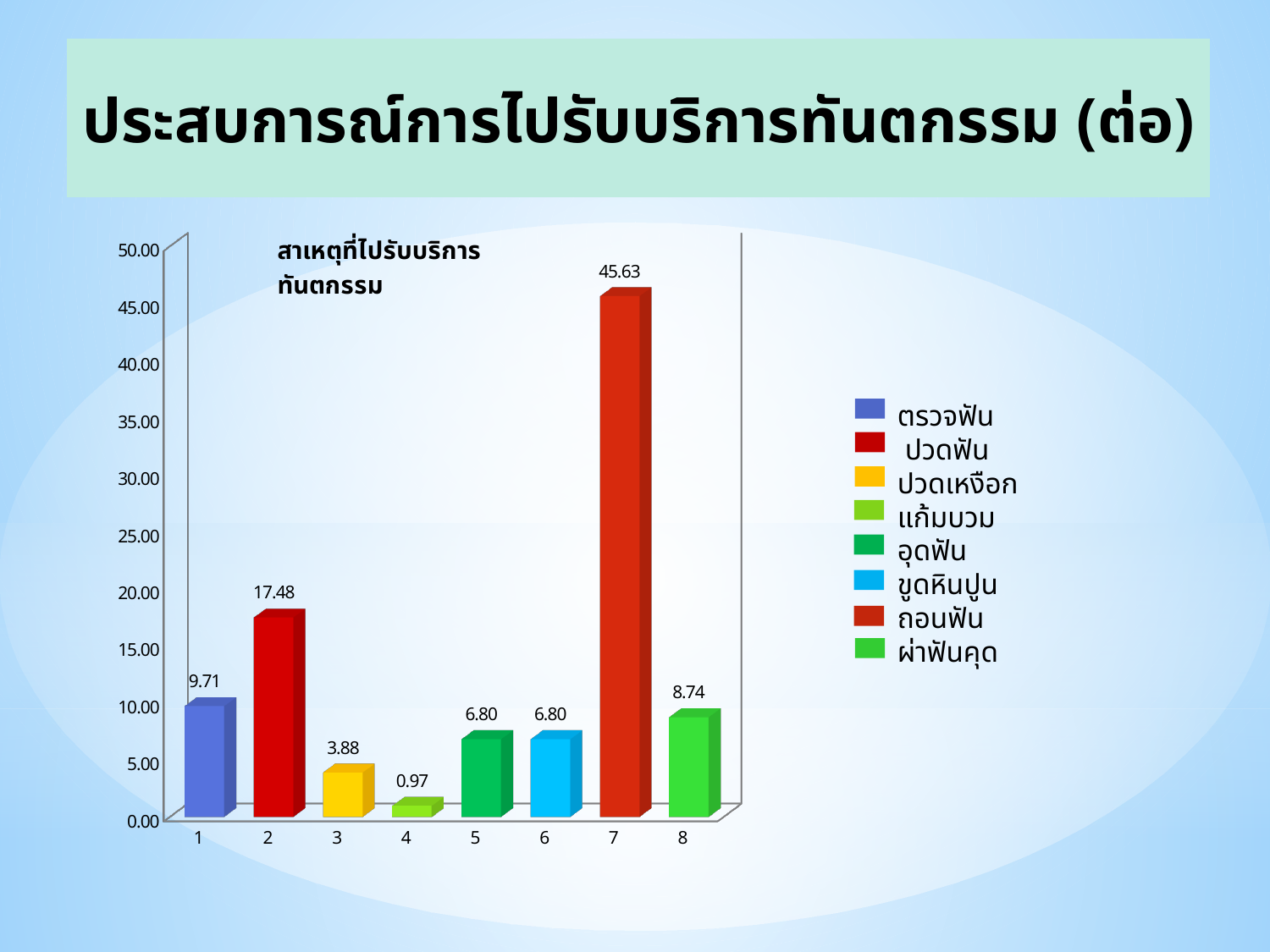
What is the value of bar 7 (ถอนฟัน) in the chart? 45.63 What is the value of bar 8 (ผ่าฟันคุด) in the chart? 8.74 Which category has the lowest value in the chart? 4 (แก้มบวม) What is the value of bar 4 (แก้มบวม) in the chart? 0.97 What type of chart is shown on the slide? bar chart How many entries does the legend list? 8 Which category has the highest value in the chart? 7 (ถอนฟัน) How many bars are plotted in the chart? 8 Which is larger, the value of bar 1 (ตรวจฟัน) or bar 8 (ผ่าฟันคุด)? bar 1 (ตรวจฟัน) What is the value of bar 2 (ปวดฟัน) in the chart? 17.48 What is the difference between the values of bar 7 and bar 2? 28.15 What is the title of the chart? สาเหตุที่ไปรับบริการทันตกรรม